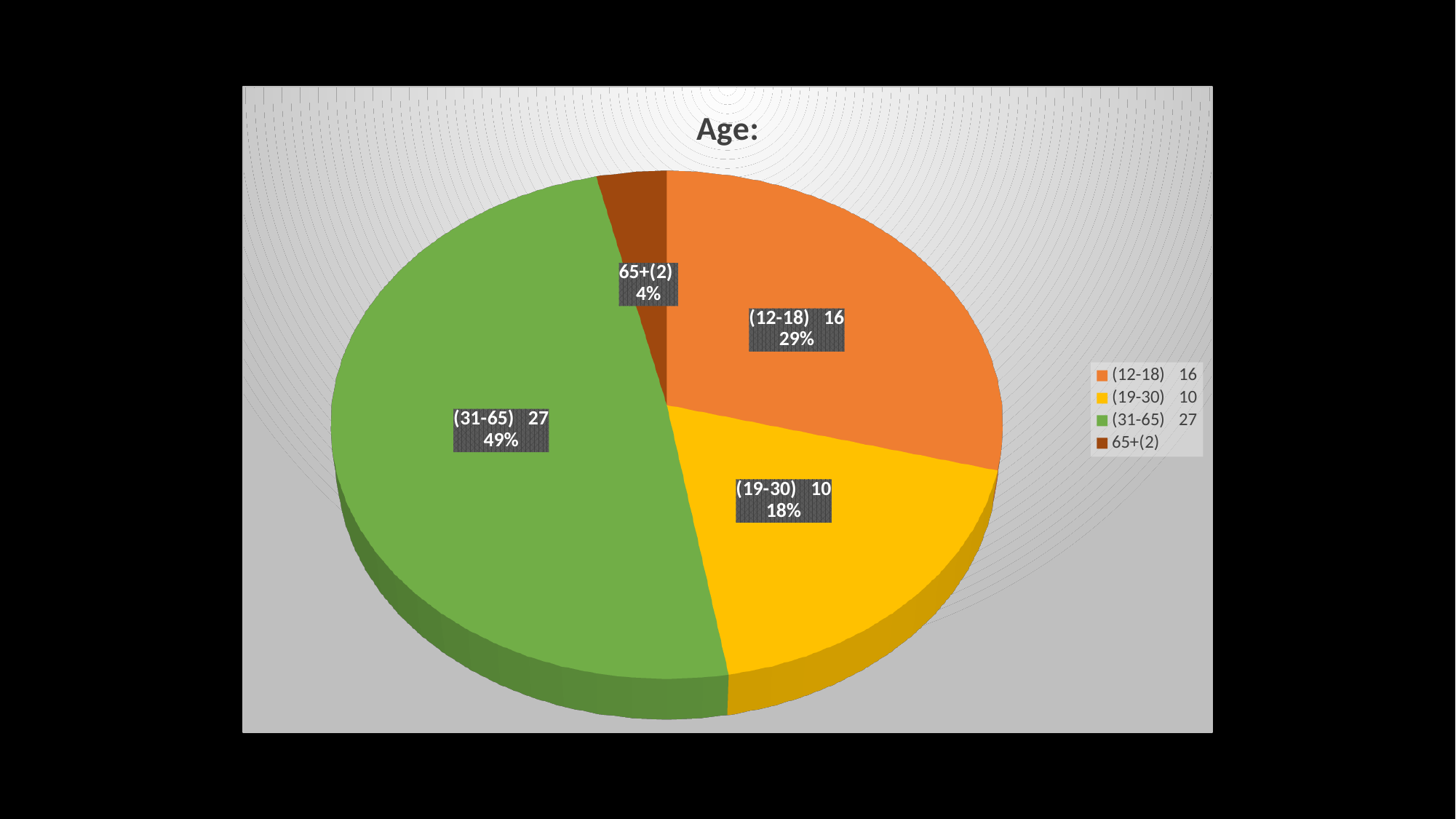
How many slices does the pie chart have? 4 What percentage share does the 65+ slice have? 4% Which slice is larger, (12-18) or (19-30)? (12-18) Which age group has the largest slice of the pie? (31-65) What is the title of the chart? Age: What percentage share does the (31-65) slice have? 49% What colour is the (19-30) slice? yellow What kind of chart is shown on the slide? pie chart What is the difference in percentage points between the (31-65) slice and the (12-18) slice? 20 What percentage share does the (19-30) slice have? 18% Which age group has the smallest slice of the pie? 65+